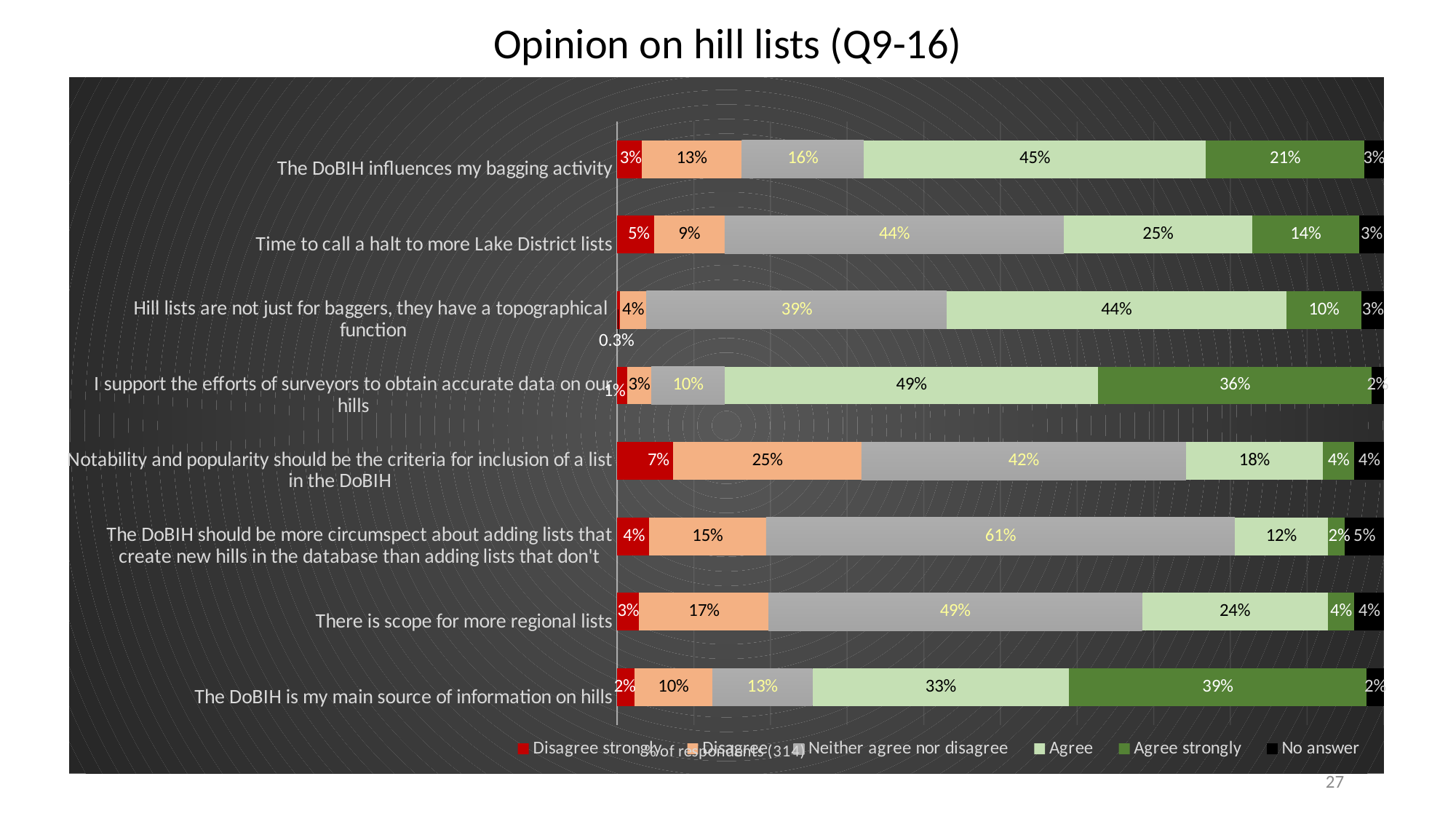
Which statement has the highest 'Agree strongly' percentage? The DoBIH is my main source of information on hills What percentage of respondents agree strongly that the DoBIH is their main source of information on hills? 39% How many statements are shown in the chart? 8 What is the 'Neither agree nor disagree' value for 'The DoBIH should be more circumspect about adding lists that create new hills in the database than adding lists that don't'? 61% Which statement has the lowest 'Disagree strongly' percentage? Hill lists are not just for baggers, they have a topographical function Which is larger: the 'Agree' value for 'The DoBIH influences my bagging activity' or the 'Agree' value for 'There is scope for more regional lists'? The DoBIH influences my bagging activity What is the difference between the 'Agree' percentages for 'I support the efforts of surveyors to obtain accurate data on our hills' and 'Time to call a halt to more Lake District lists'? 24% How many series does the legend list? 6 What percentage of respondents disagree with 'Notability and popularity should be the criteria for inclusion of a list in the DoBIH'? 25% What is the title of the chart? Opinion on hill lists (Q9-16) Which statement has the highest 'Neither agree nor disagree' percentage? The DoBIH should be more circumspect about adding lists that create new hills in the database than adding lists that don't What kind of chart is shown on the slide? Stacked bar chart